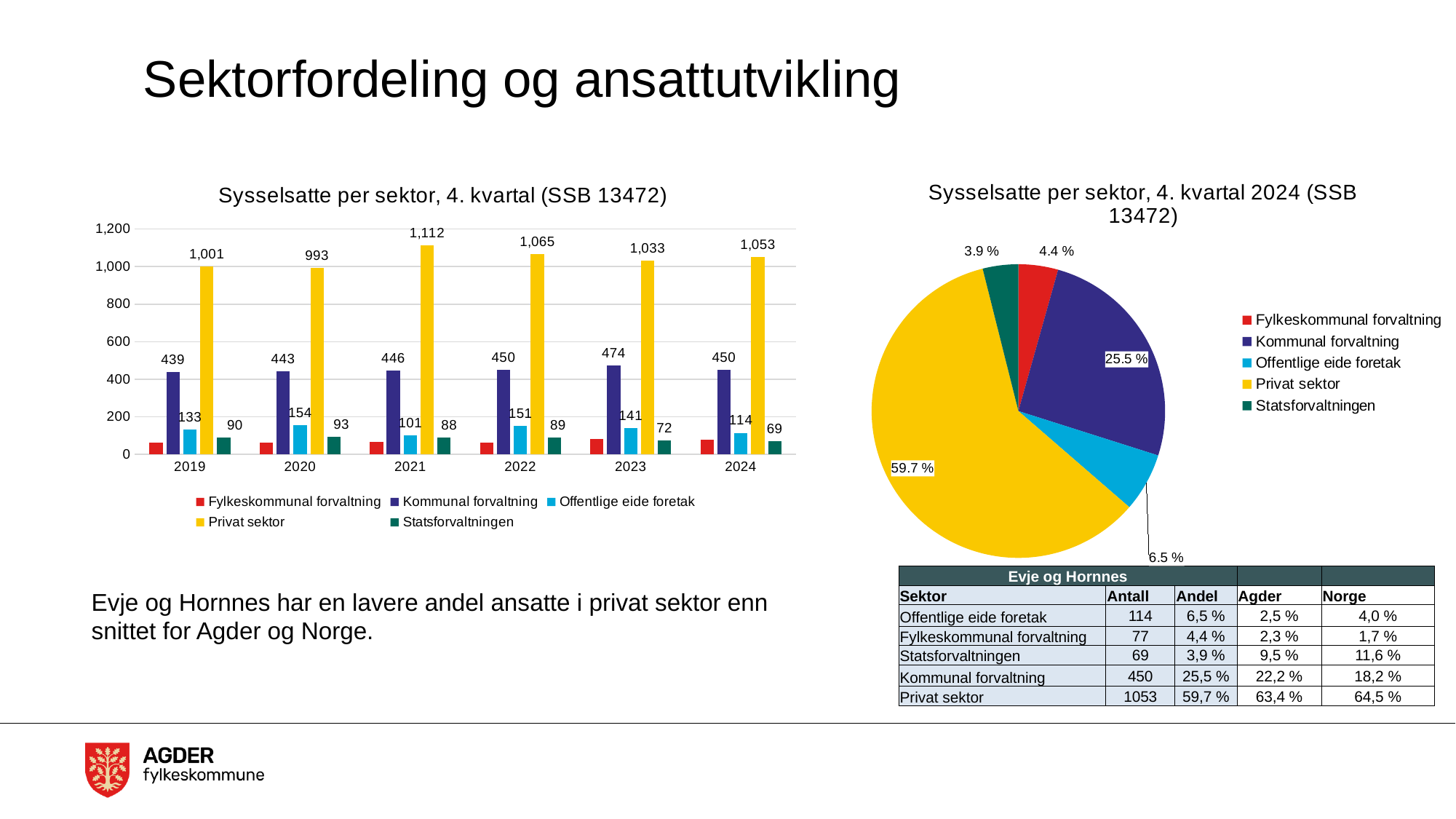
What kind of chart is 'Sysselsatte per sektor, 4. kvartal (SSB 13472)' on the left of the slide? bar chart In the bar chart 'Sysselsatte per sektor, 4. kvartal (SSB 13472)', which year has the larger value for Offentlige eide foretak, 2020 or 2024? 2020 In the pie chart 'Sysselsatte per sektor, 4. kvartal 2024 (SSB 13472)', what share does Privat sektor have? 59.7 % In the pie chart 'Sysselsatte per sektor, 4. kvartal 2024 (SSB 13472)', what is the value shown for Kommunal forvaltning? 25.5 % In the bar chart 'Sysselsatte per sektor, 4. kvartal (SSB 13472)', how many series does the legend list? 5 In the bar chart 'Sysselsatte per sektor, 4. kvartal (SSB 13472)', how many years are shown on the x axis? 6 In the bar chart 'Sysselsatte per sektor, 4. kvartal (SSB 13472)', in which year is the Privat sektor value highest? 2021 In the bar chart 'Sysselsatte per sektor, 4. kvartal (SSB 13472)', do the Statsforvaltningen values overall rise or fall from 2019 to 2024? fall In the bar chart 'Sysselsatte per sektor, 4. kvartal (SSB 13472)', what is the value for Privat sektor in 2021? 1,112 In the bar chart 'Sysselsatte per sektor, 4. kvartal (SSB 13472)', is the value for Fylkeskommunal forvaltning in 2024 greater or less than 200? less In the bar chart 'Sysselsatte per sektor, 4. kvartal (SSB 13472)', in which year is the Statsforvaltningen value lowest? 2024 In the bar chart 'Sysselsatte per sektor, 4. kvartal (SSB 13472)', what is the difference between the Kommunal forvaltning values for 2023 and 2022? 24